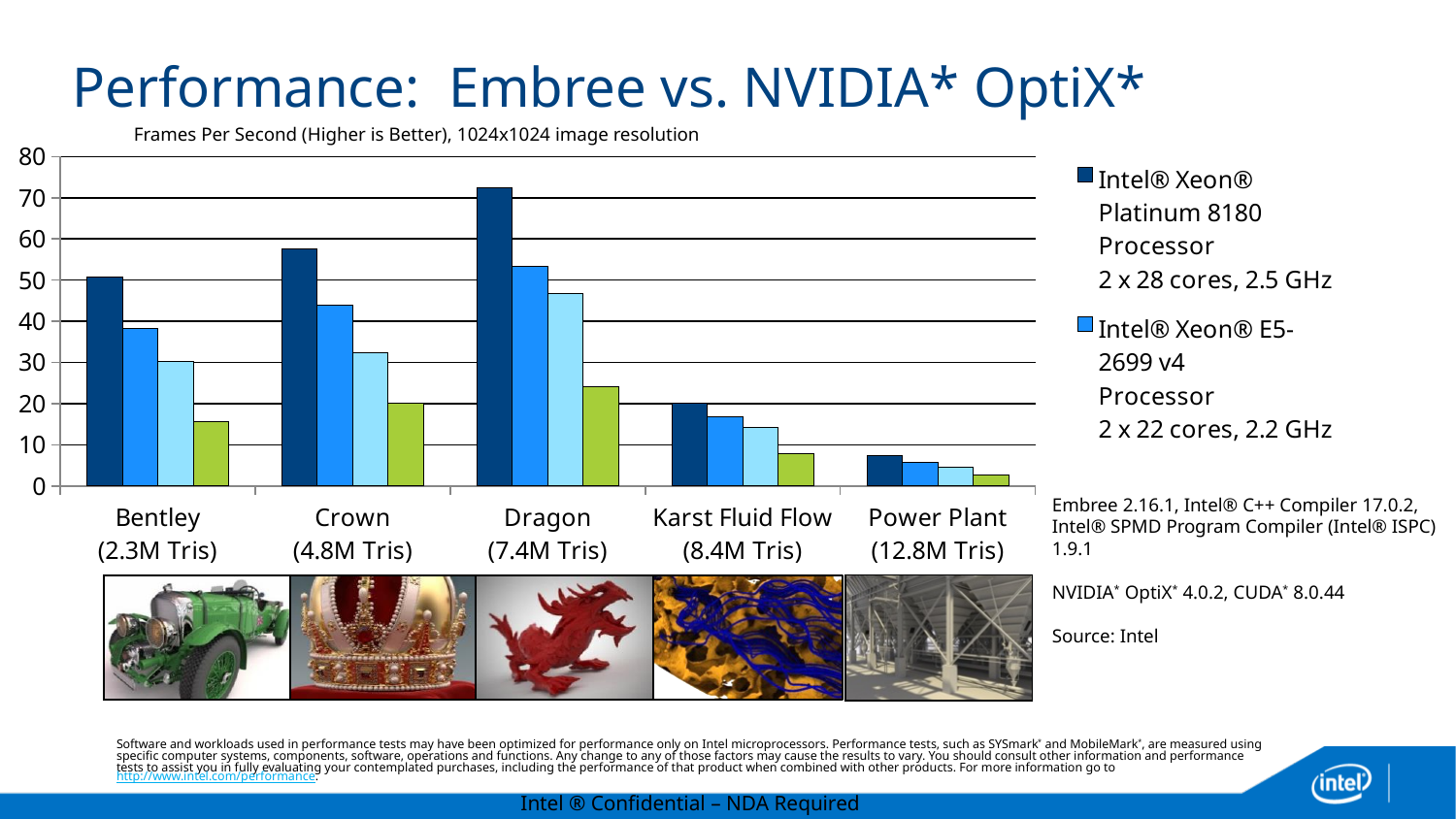
Is the Intel Xeon Platinum 8180 Processor value for Dragon greater or less than 60? greater For the Intel Xeon Platinum 8180 Processor, which scene has the larger value: Bentley or Crown? Crown What metric does the chart's subtitle say is plotted? Frames Per Second (Higher is Better), 1024x1024 image resolution Which scene has the highest frames per second for the Intel Xeon E5-2699 v4 Processor? Dragon How many scene categories are shown on the x axis of the chart? 5 Do the Intel Xeon Platinum 8180 Processor values rise or fall from Dragon to Power Plant along the x axis? fall What kind of chart is shown on the slide? bar chart Is the Intel Xeon Platinum 8180 Processor value for Crown greater or less than 50? greater Which scene has the highest frames per second for the Intel Xeon Platinum 8180 Processor? Dragon Is the Intel Xeon Platinum 8180 Processor value for Power Plant greater or less than 10? less Which scene has the lowest frames per second for the Intel Xeon Platinum 8180 Processor? Power Plant